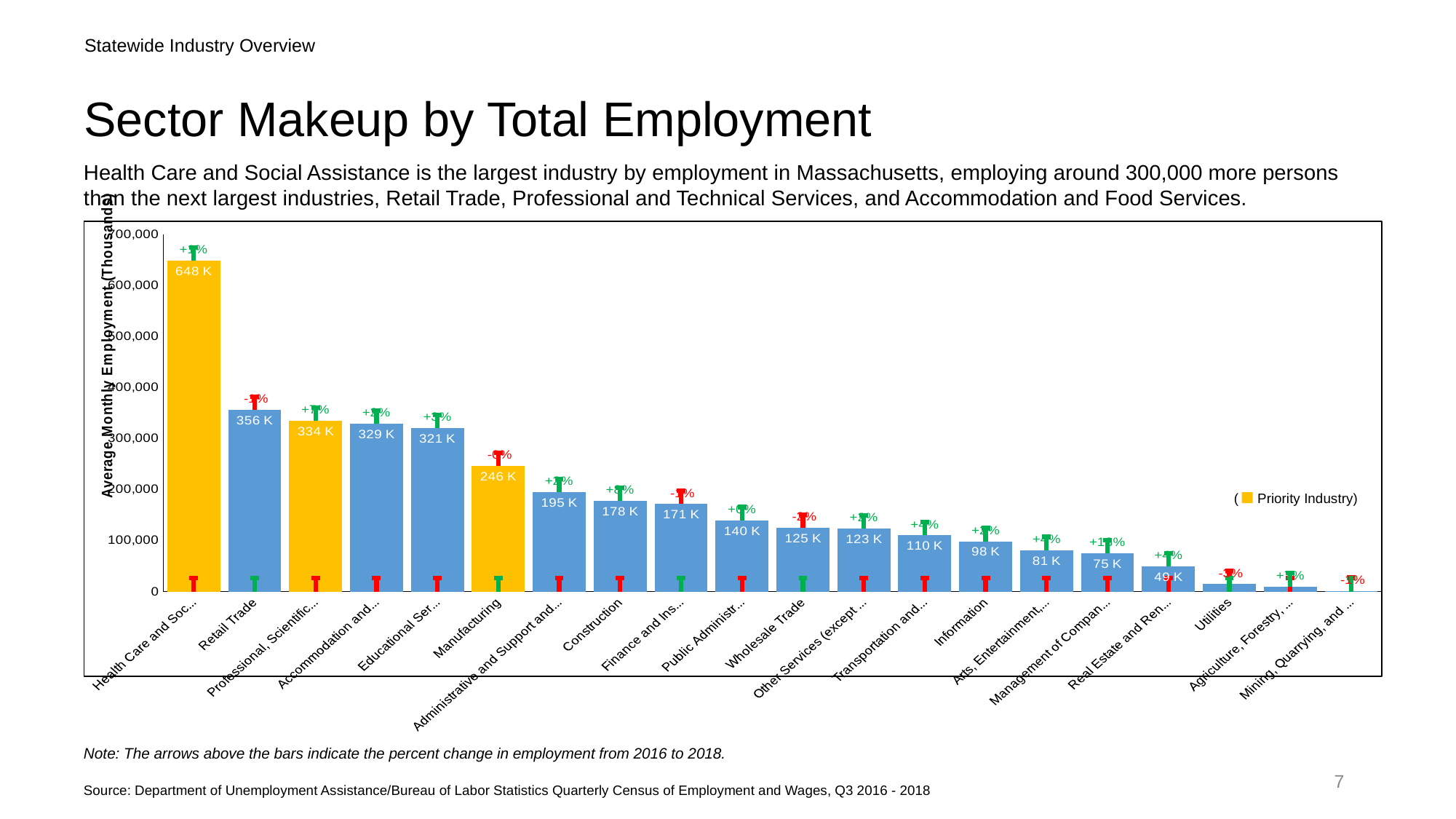
What is the average monthly employment for Wholesale Trade? 125 K How many bars are coloured orange as Priority Industries? 3 What type of chart is shown on the slide? bar chart How many industries are shown in the chart? 20 What is the average monthly employment for Construction? 178 K Which industry has the highest average monthly employment? Health Care and Social Assistance What is the average monthly employment for Manufacturing? 246 K What is the average monthly employment for Information? 98 K What is the average monthly employment for Retail Trade? 356 K Which has higher average monthly employment, Construction or Wholesale Trade? Construction Is the average monthly employment for Utilities greater or less than 100,000? less What is the difference in average monthly employment between Retail Trade and Manufacturing? 110 K